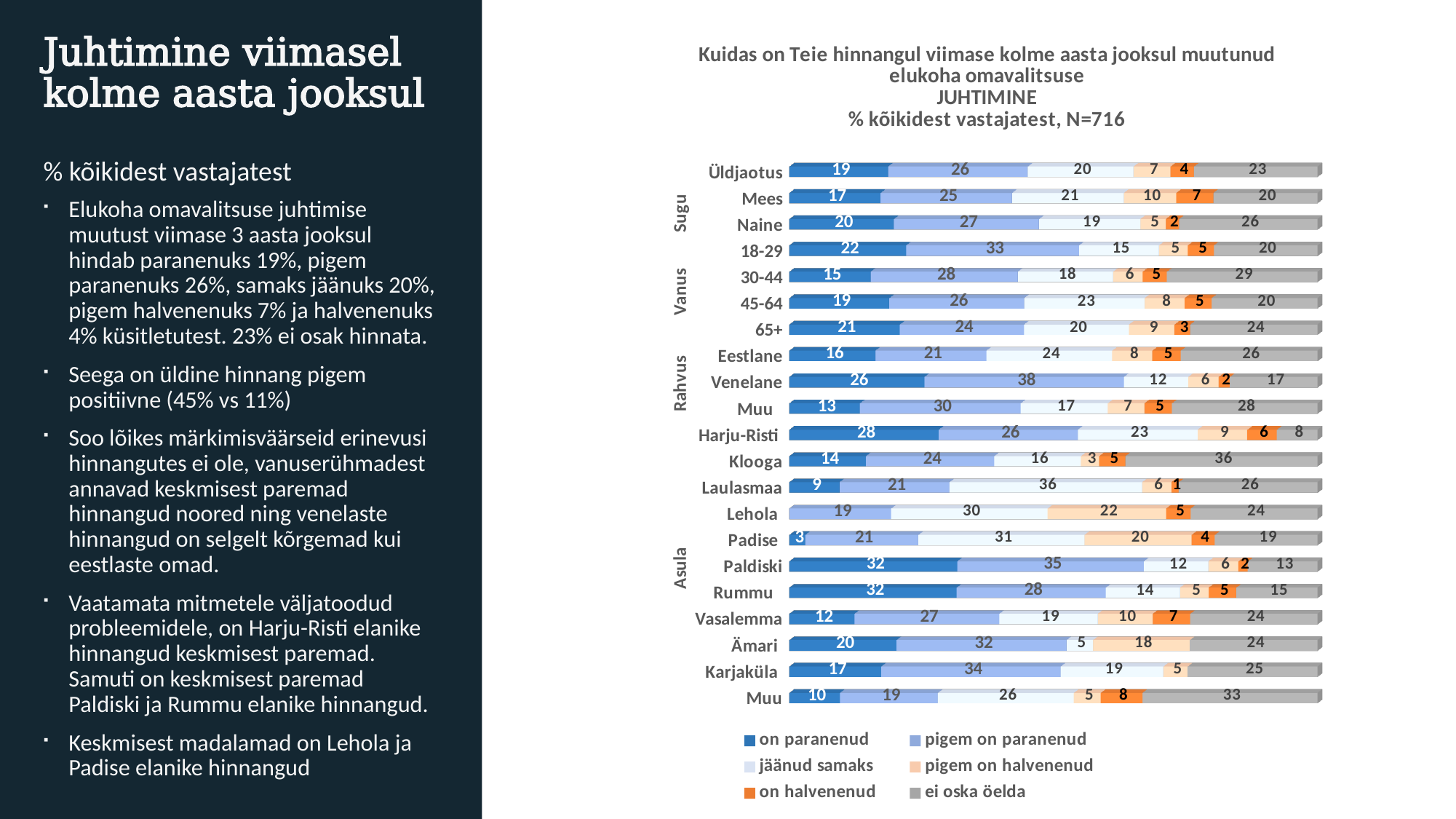
Which category has the lowest 'ei oska öelda' value? Harju-Risti What is the N (number of respondents) stated in the chart title? N=716 How many categories (rows) are plotted in the chart? 21 What is the 'jäänud samaks' value for Laulasmaa? 36 What type of chart is shown on the slide? Stacked bar chart What is the 'pigem on paranenud' value for Venelane? 38 What is the 'ei oska öelda' value for Klooga? 36 What is the 'on paranenud' value for Üldjaotus? 19 Which has a larger 'on paranenud' value, Harju-Risti or Laulasmaa? Harju-Risti What is the difference between the 'on halvenenud' values for Mees and Naine? 5 Which category has the highest 'pigem on paranenud' value? Venelane How many series does the legend list? 6